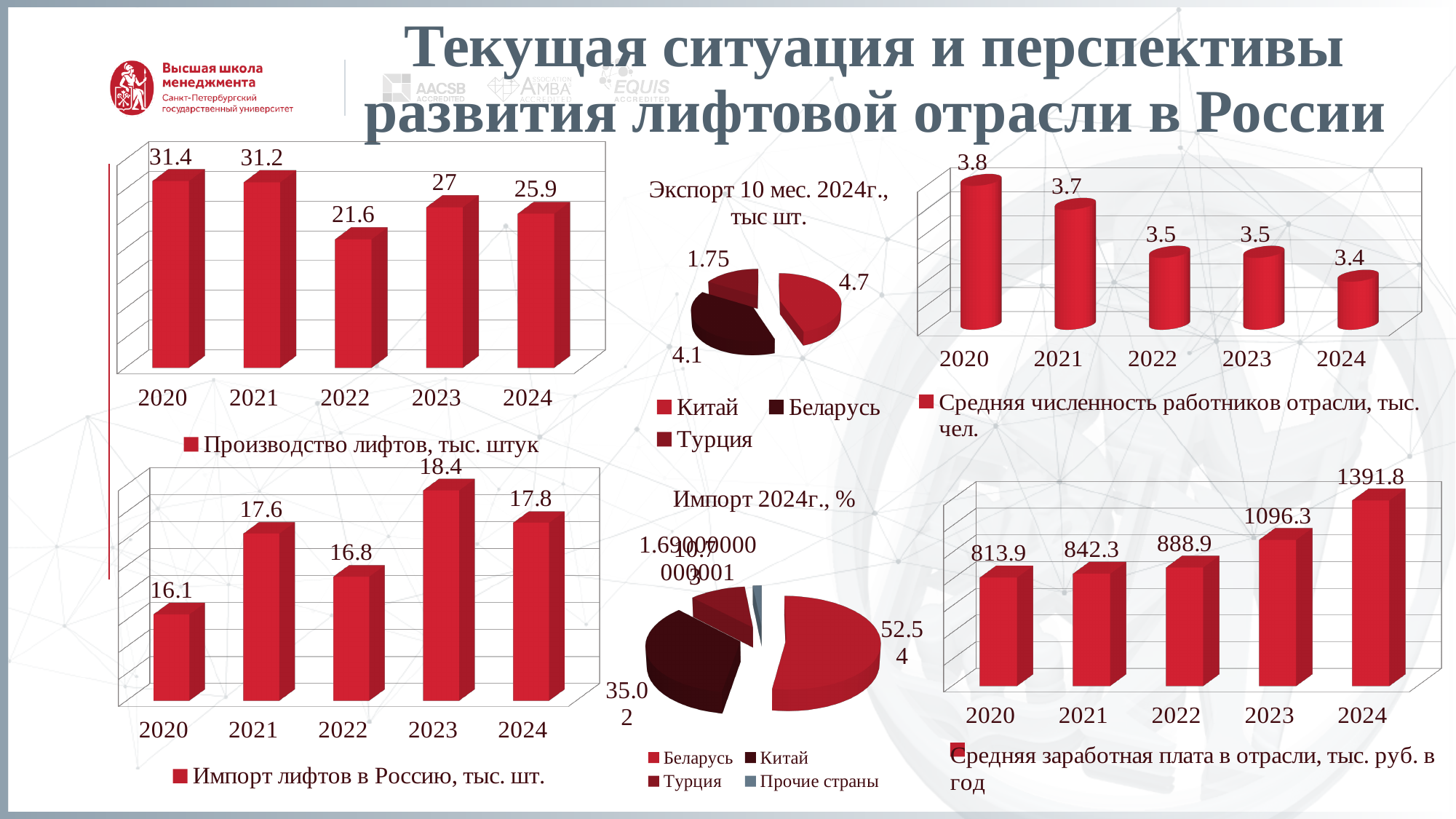
In the 'Производство лифтов, тыс. штук' chart, which year has the highest value? 2020 In the 'Импорт лифтов в Россию, тыс. шт.' chart, how many years are shown? 5 In the 'Экспорт 10 мес. 2024г., тыс шт.' pie chart, which country has the smallest slice? Турция In the 'Импорт лифтов в Россию, тыс. шт.' chart, which year has the lowest value? 2020 In the 'Экспорт 10 мес. 2024г., тыс шт.' pie chart, what is the value for Беларусь? 4.1 In the 'Производство лифтов, тыс. штук' chart, what is the value for 2022? 21.6 How many countries does the legend of the 'Импорт 2024г., %' pie chart list? 4 In the 'Средняя численность работников отрасли, тыс. чел.' chart, what is the value for 2024? 3.4 In the 'Производство лифтов, тыс. штук' chart, what is the difference between the 2020 and 2024 values? 5.5 In the 'Средняя численность работников отрасли, тыс. чел.' chart, do the values rise or fall from 2020 to 2024? fall In the 'Импорт лифтов в Россию, тыс. шт.' chart, what is the value for 2023? 18.4 In the 'Средняя заработная плата в отрасли, тыс. руб. в год' chart, what is the value for 2023? 1096.3